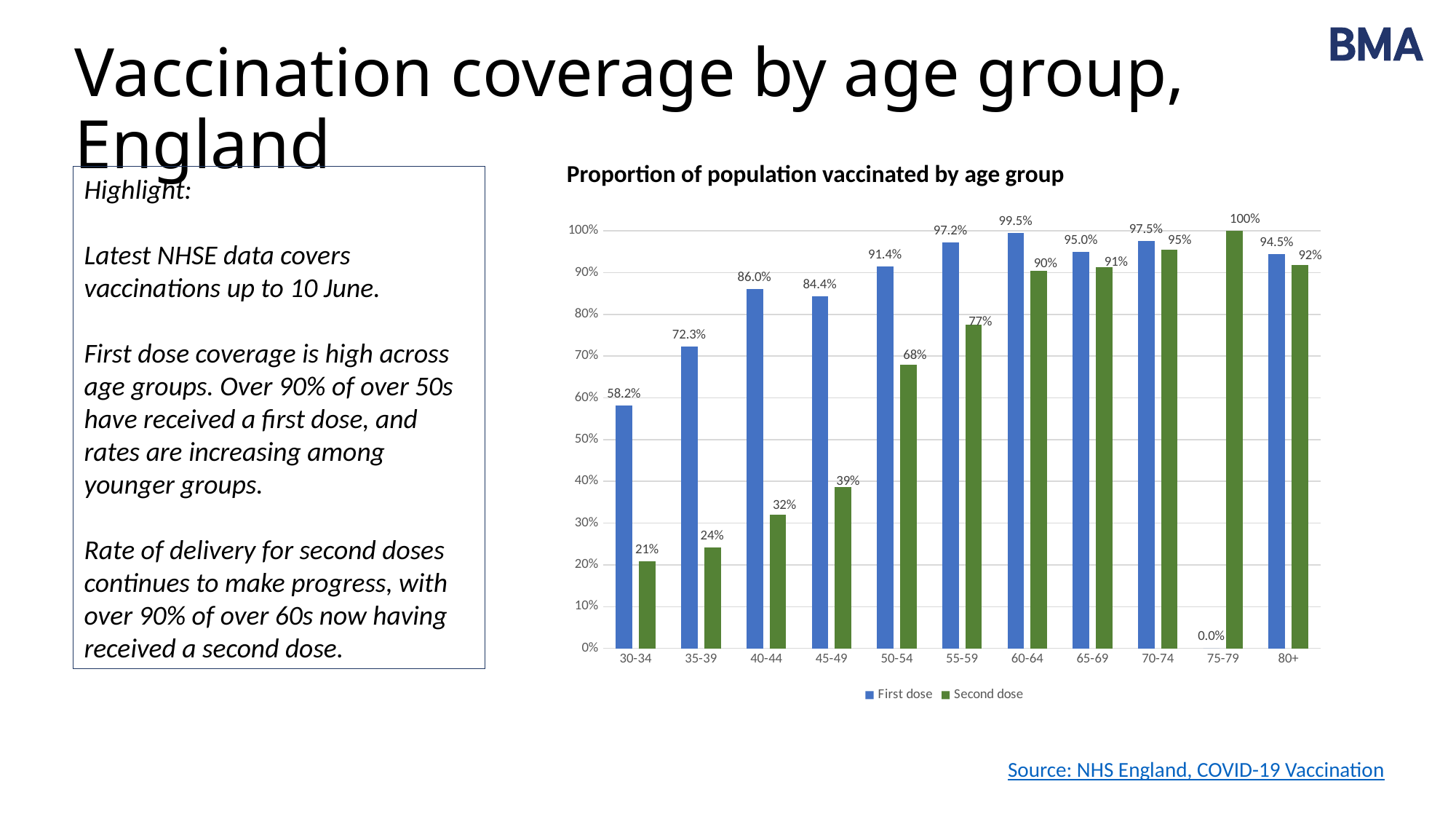
Which age group has the lowest Second dose value? 30-34 What is the First dose value for the 30-34 age group? 58.2% What First dose value is shown for the 75-79 age group? 0.0% What is the difference between the First dose and Second dose values for the 60-64 age group? 9.5 percentage points How many series does the legend list? 2 How many age groups are shown on the x axis? 11 What is the Second dose value for the 50-54 age group? 68% What kind of chart is shown on the slide? Bar chart Which age group has the highest First dose value? 60-64 Which has the larger Second dose value, the 70-74 age group or the 80+ age group? 70-74 Do the Second dose values rise or fall from the 30-34 age group to the 70-74 age group? Rise What is the title of the chart? Proportion of population vaccinated by age group